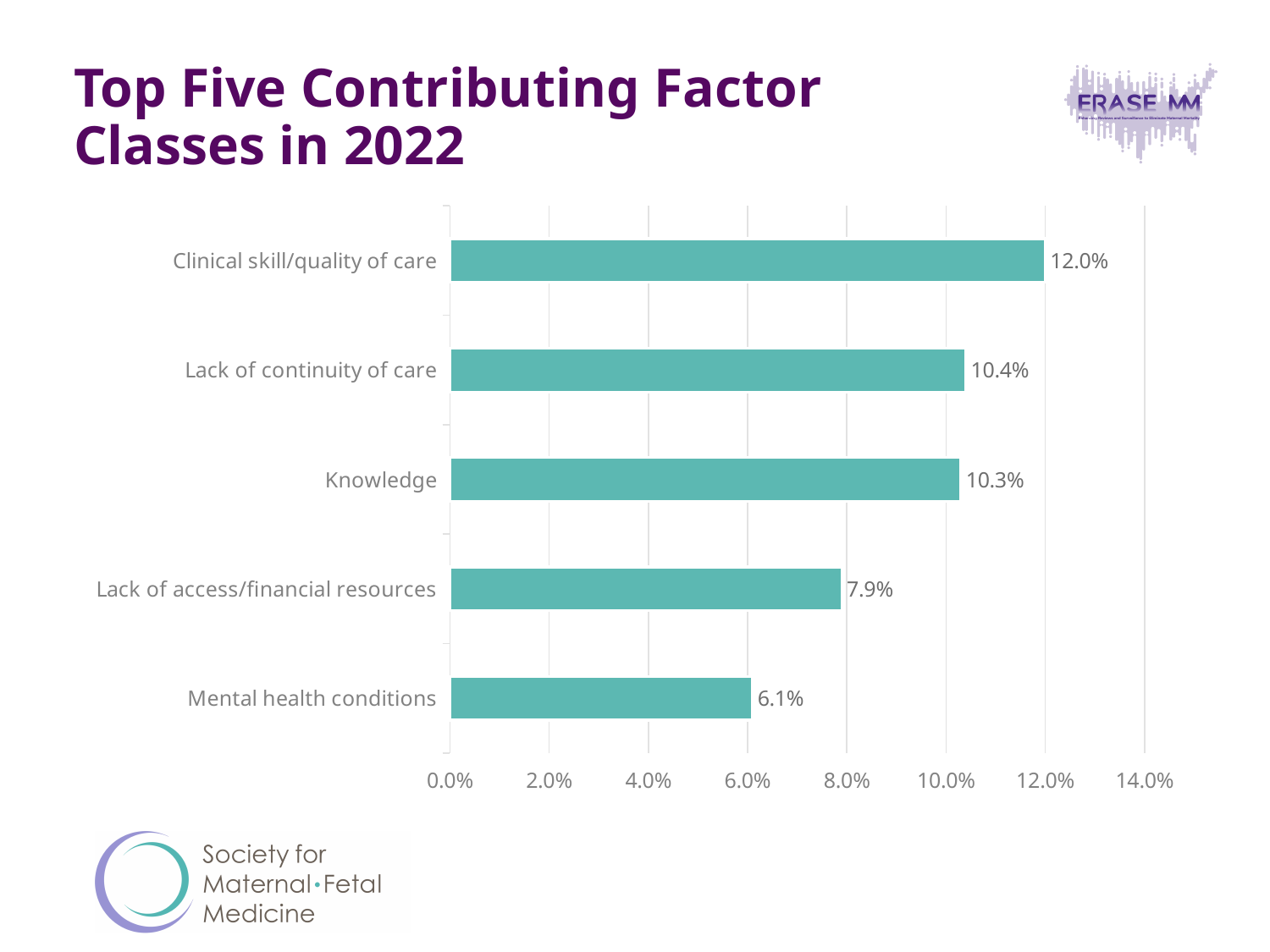
Which contributing factor class has the lowest value? Mental health conditions What is the difference between the values for Clinical skill/quality of care and Mental health conditions? 5.9% Which contributing factor class has the highest value? Clinical skill/quality of care Which is larger, the value for Lack of access/financial resources or the value for Mental health conditions? Lack of access/financial resources How many contributing factor classes are shown in the chart? 5 What is the value for Lack of access/financial resources? 7.9% What is the title of the slide? Top Five Contributing Factor Classes in 2022 What is the value for Clinical skill/quality of care? 12.0% What is the value for Knowledge? 10.3% What is the value for Mental health conditions? 6.1% What is the value for Lack of continuity of care? 10.4% What kind of chart is shown on the slide? Bar chart